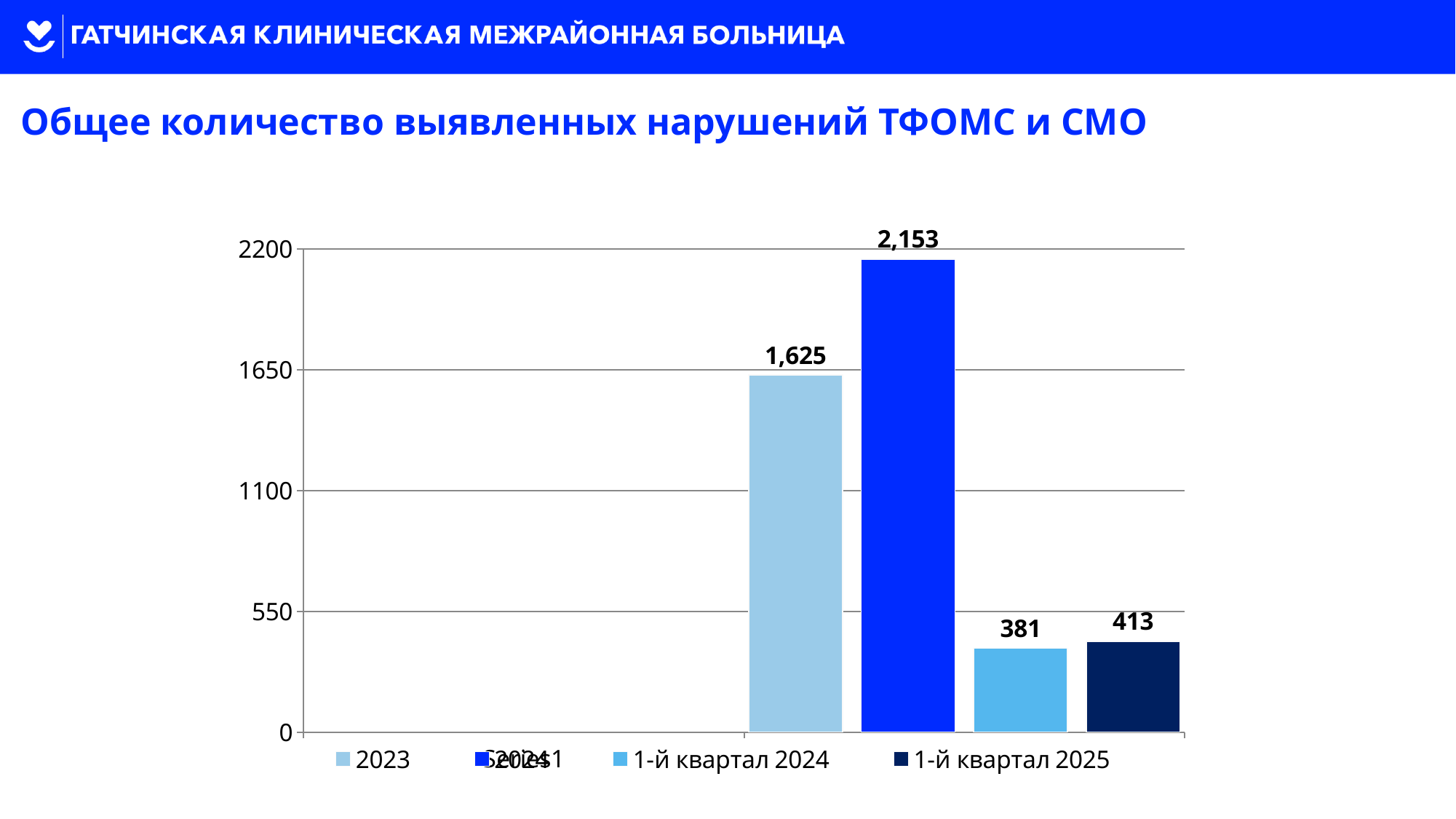
What is the difference between the values for 1-й квартал 2025 and 1-й квартал 2024? 32 Which category has the highest value? 2024 What kind of chart is shown on the slide? bar chart Which is larger, the value for 1-й квартал 2025 or the value for 1-й квартал 2024? 1-й квартал 2025 What is the value shown on the tallest bar (the dark blue bar for 2024)? 2,153 What is the value for 1-й квартал 2025? 413 What is the value for 2023? 1,625 What is the difference between the values for 2024 and 2023? 528 Is the value for 2023 greater or less than 1100? greater What is the value for 1-й квартал 2024? 381 Which category has the lowest value? 1-й квартал 2024 How many bars are plotted in the chart? 4